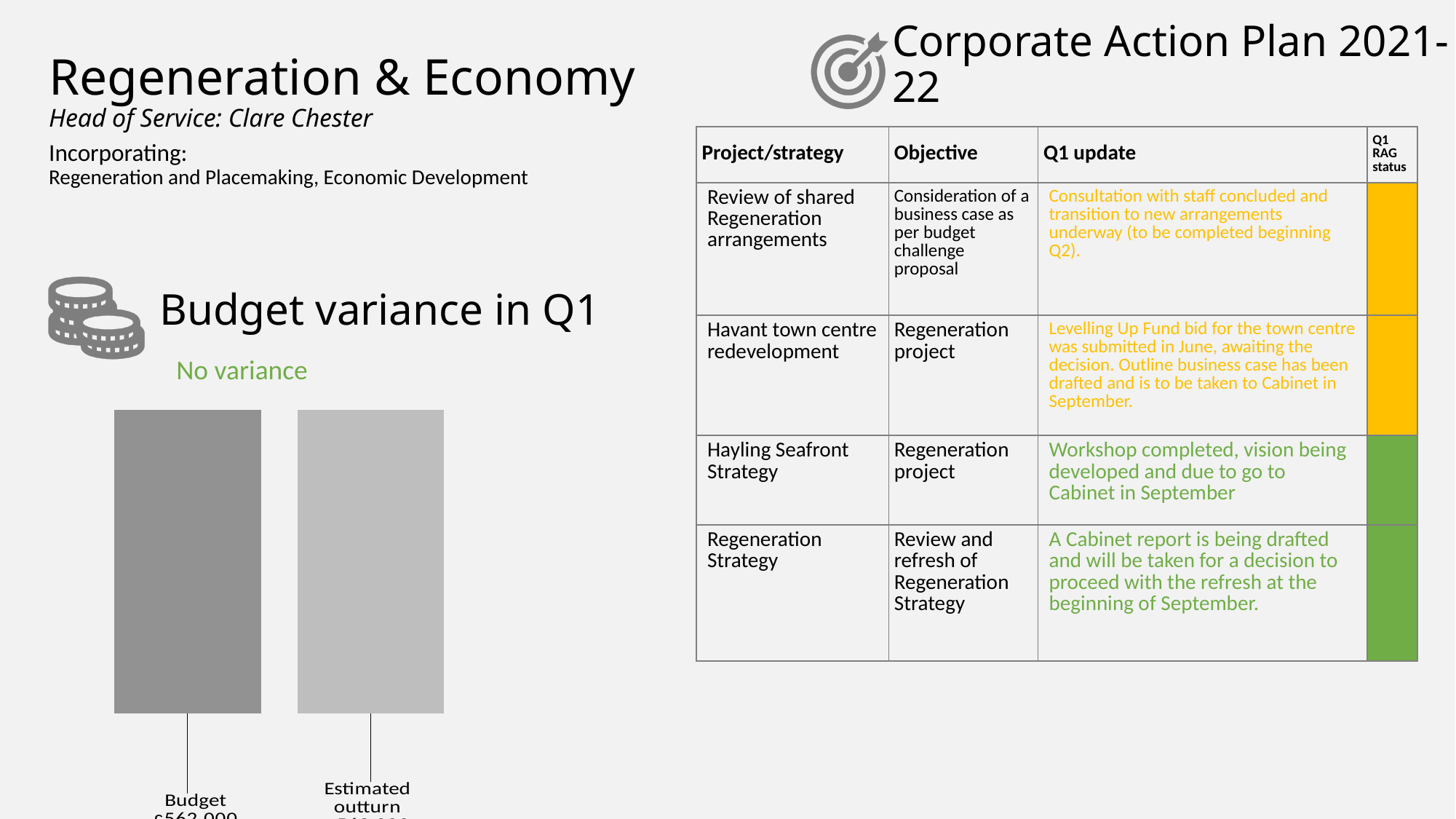
What is the title of the chart on the left of the slide? Budget variance in Q1 In the budget variance chart, is the Budget bar taller than, shorter than, or the same height as the Estimated outturn bar? the same height How many bars does the budget variance chart show? 2 What does the green text above the budget variance chart say? No variance What kind of chart is shown under the heading 'Budget variance in Q1'? bar chart What is the label of the second (right) bar in the budget variance chart? Estimated outturn What is the label of the first (left) bar in the budget variance chart? Budget